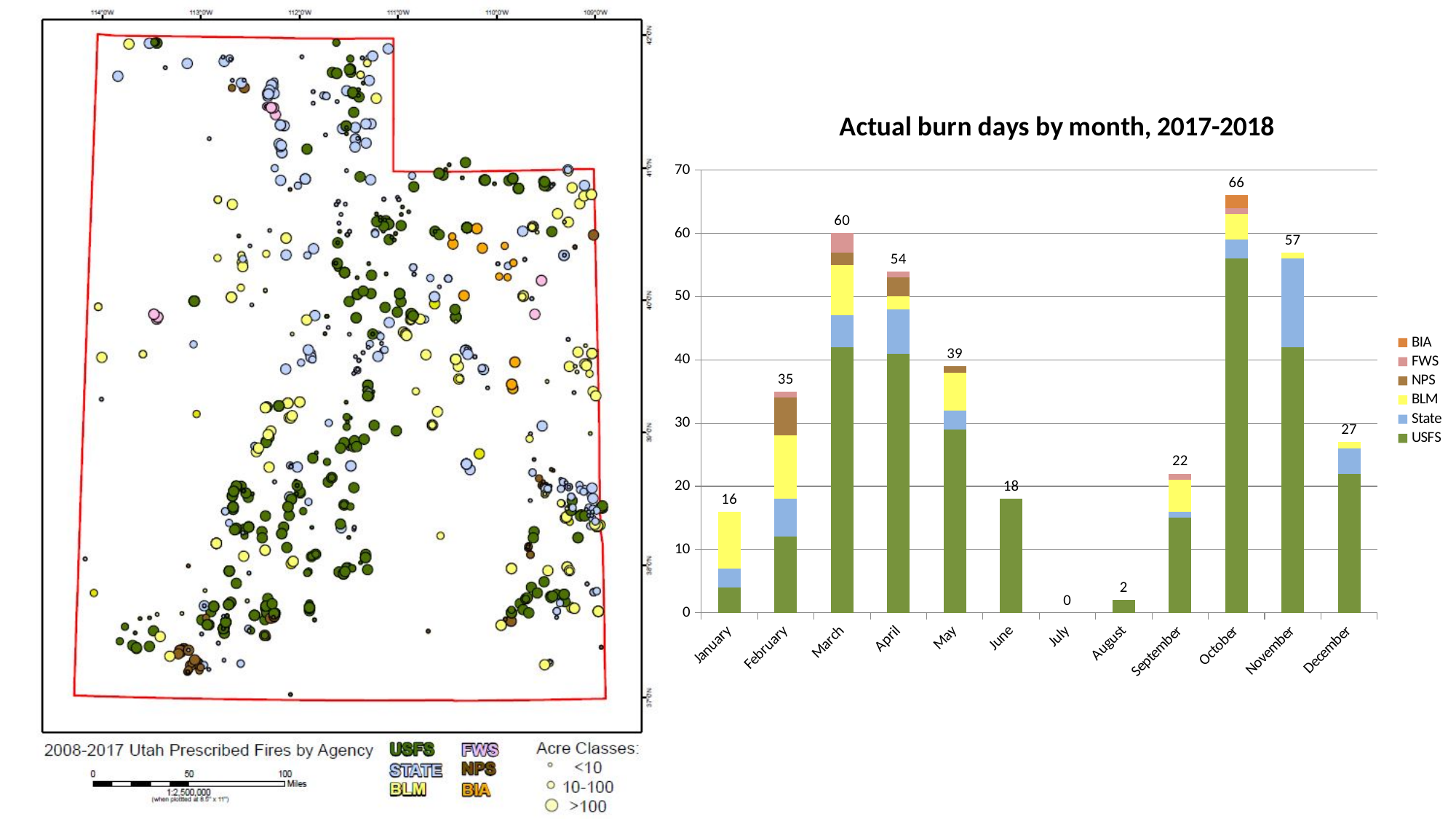
In the 'Actual burn days by month, 2017-2018' chart, is the USFS value for November greater or less than 40? greater How many months are shown on the x axis of the 'Actual burn days by month, 2017-2018' chart? 12 In the 'Actual burn days by month, 2017-2018' chart, which month has the lowest total burn days? July In the 'Actual burn days by month, 2017-2018' chart, what is the total number of burn days in March? 60 What kind of chart is 'Actual burn days by month, 2017-2018'? Stacked bar chart In the 'Actual burn days by month, 2017-2018' chart, what is the total number of burn days in October? 66 In the 'Actual burn days by month, 2017-2018' chart, which month has more total burn days, April or May? April In the 'Actual burn days by month, 2017-2018' chart, do the total burn days rise or fall from March to July? Fall In the 'Actual burn days by month, 2017-2018' chart, which month has the highest total burn days? October How many series does the legend of the 'Actual burn days by month, 2017-2018' chart list? 6 In the 'Actual burn days by month, 2017-2018' chart, what is the difference between the total burn days in October and November? 9 In the 'Actual burn days by month, 2017-2018' chart, which agency is shown in green? USFS